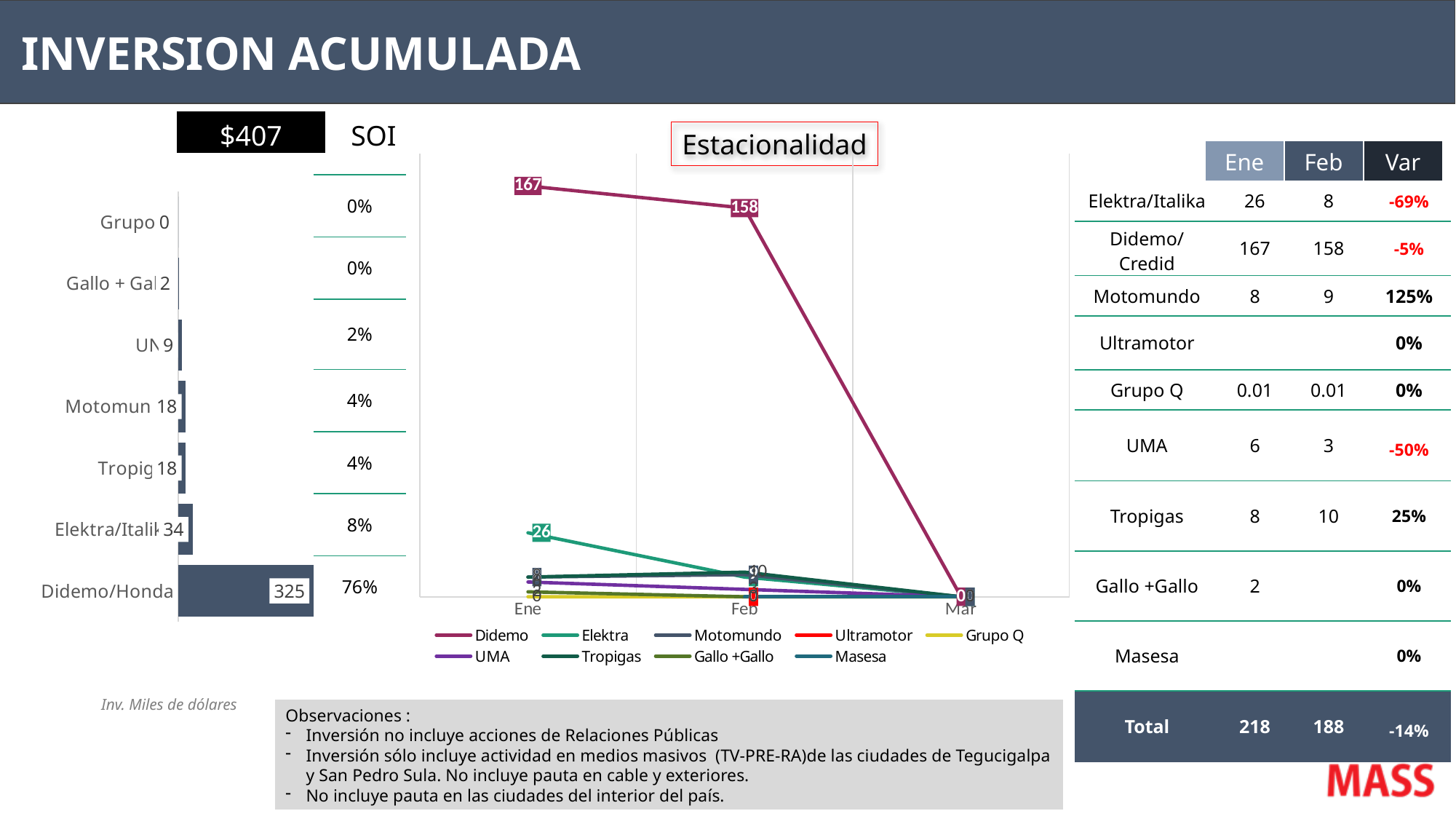
In the 'Estacionalidad' chart, which is larger in Ene: Didemo or Elektra? Didemo In the 'Estacionalidad' chart, what is the value for Elektra in Ene? 26 In the bar chart on the left, which category has the highest value? Didemo/Honda In the bar chart on the left, what is the value for Didemo/Honda? 325 In the bar chart on the left, what is the difference between the values for Didemo/Honda and Elektra/Italika? 291 In the bar chart on the left, how many categories are shown? 7 What type of chart is the 'Estacionalidad' chart? line chart In the 'Estacionalidad' chart, what is the value for Didemo in Feb? 158 In the 'Estacionalidad' chart, does the Didemo line rise or fall from Ene to Mar? fall What type of chart is the chart on the left of the slide? bar chart In the 'Estacionalidad' chart, what is the value for Didemo in Ene? 167 In the 'Estacionalidad' chart, how many series does the legend list? 9